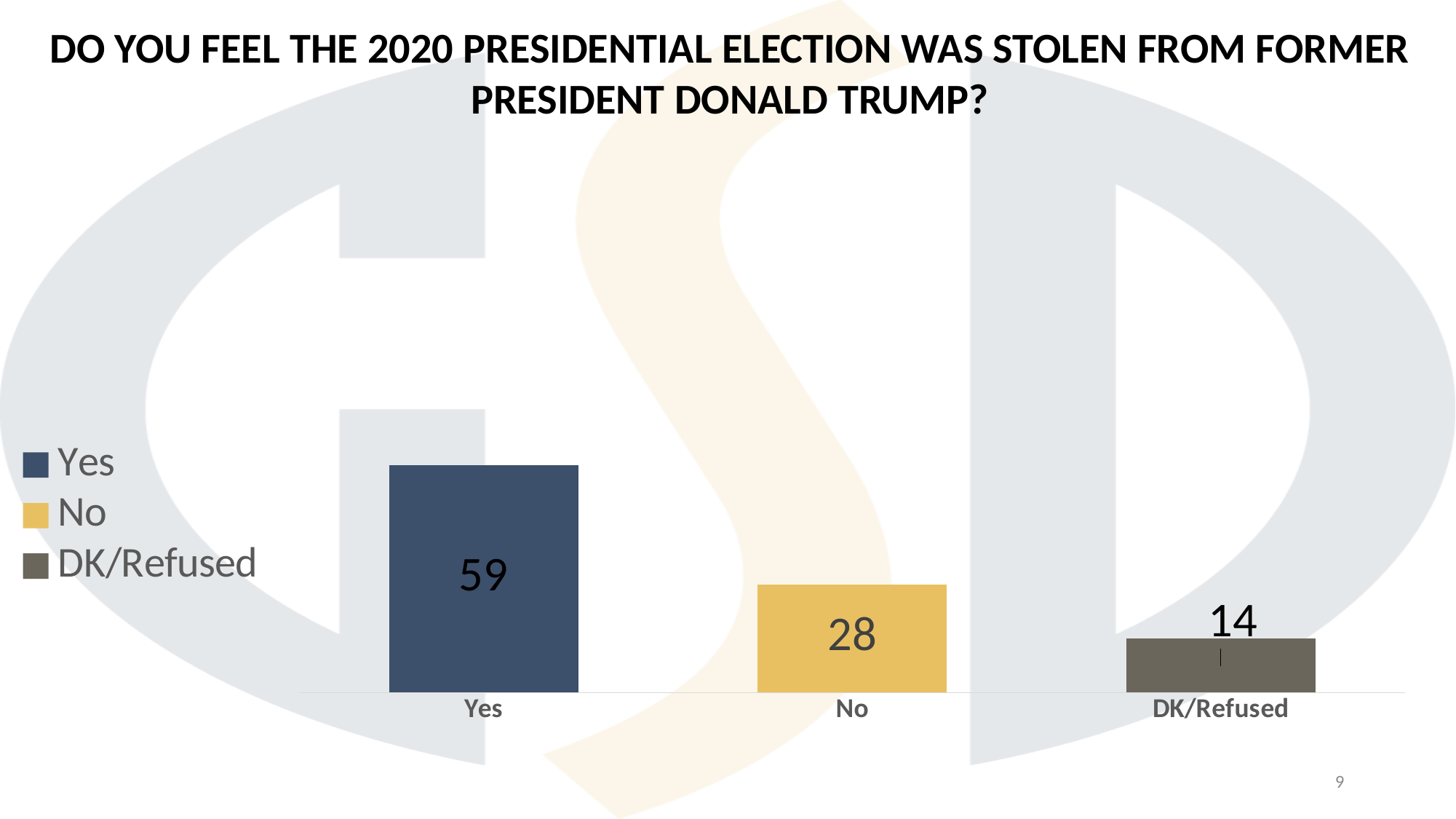
How many categories are shown on the x axis? 3 What kind of chart is shown on the slide? Bar chart What is the value for Yes? 59 Which is larger, the value for No or the value for DK/Refused? No What is the value for No? 28 How many entries does the legend list? 3 Which category has the highest value? Yes Which legend entry is shown in yellow? No What is the difference between the values for No and DK/Refused? 14 Which category has the lowest value? DK/Refused What is the value for DK/Refused? 14 What is the difference between the values for Yes and No? 31